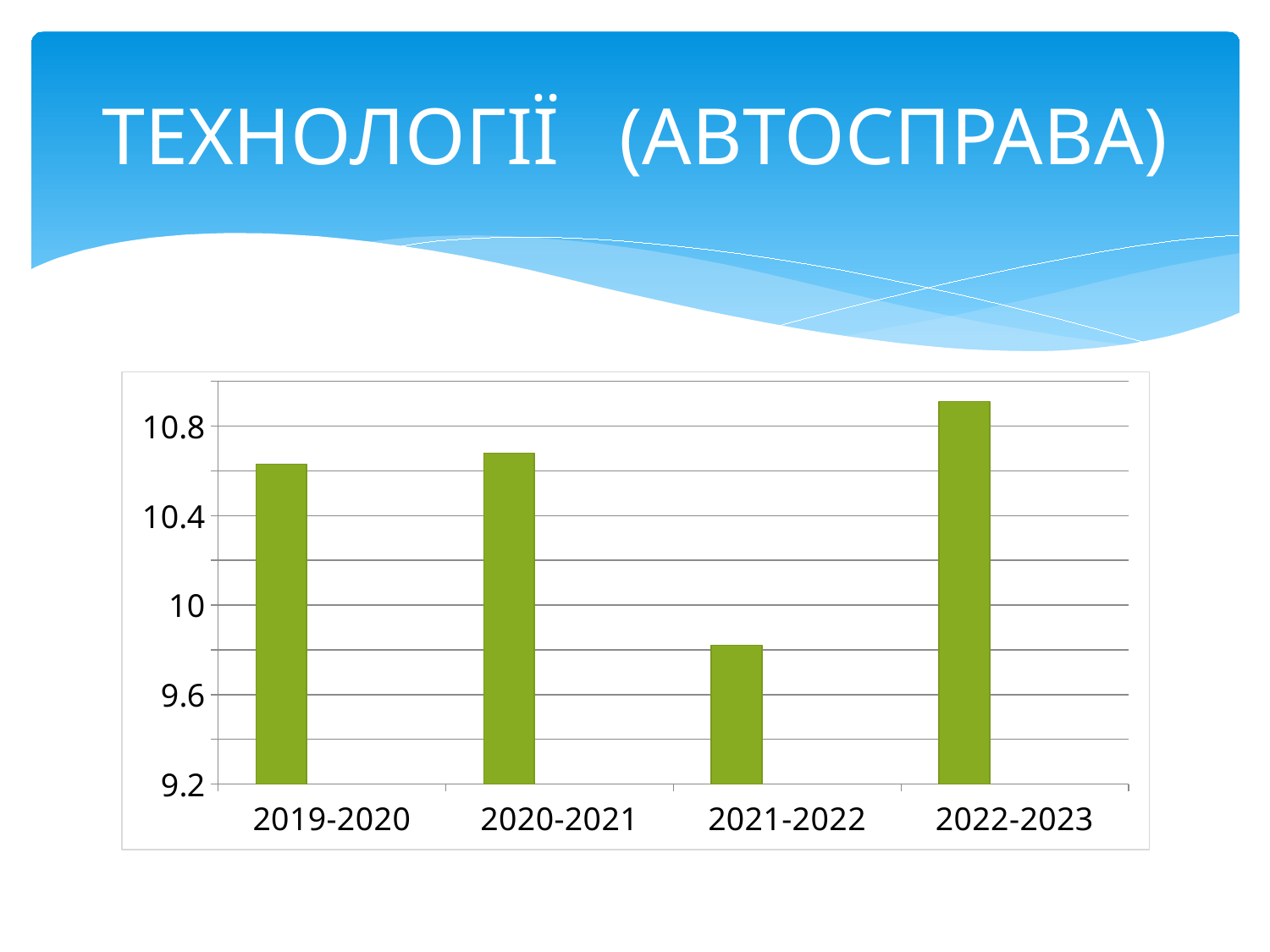
Is the value for 2022-2023 greater or less than 10.8? greater Is the value for 2020-2021 greater or less than 10.8? less Which school year has the lowest bar in the chart? 2021-2022 Is the value for 2021-2022 greater or less than 10? less Which is larger, the value for 2019-2020 or the value for 2021-2022? 2019-2020 Which is larger, the value for 2022-2023 or the value for 2021-2022? 2022-2023 How many categories (school years) are shown on the x axis of the chart? 4 What is the title of the slide containing the chart? ТЕХНОЛОГІЇ (АВТОСПРАВА) Does the value rise or fall from 2021-2022 to 2022-2023? rise Which school year has the highest bar in the chart? 2022-2023 What kind of chart is shown on the slide? bar chart